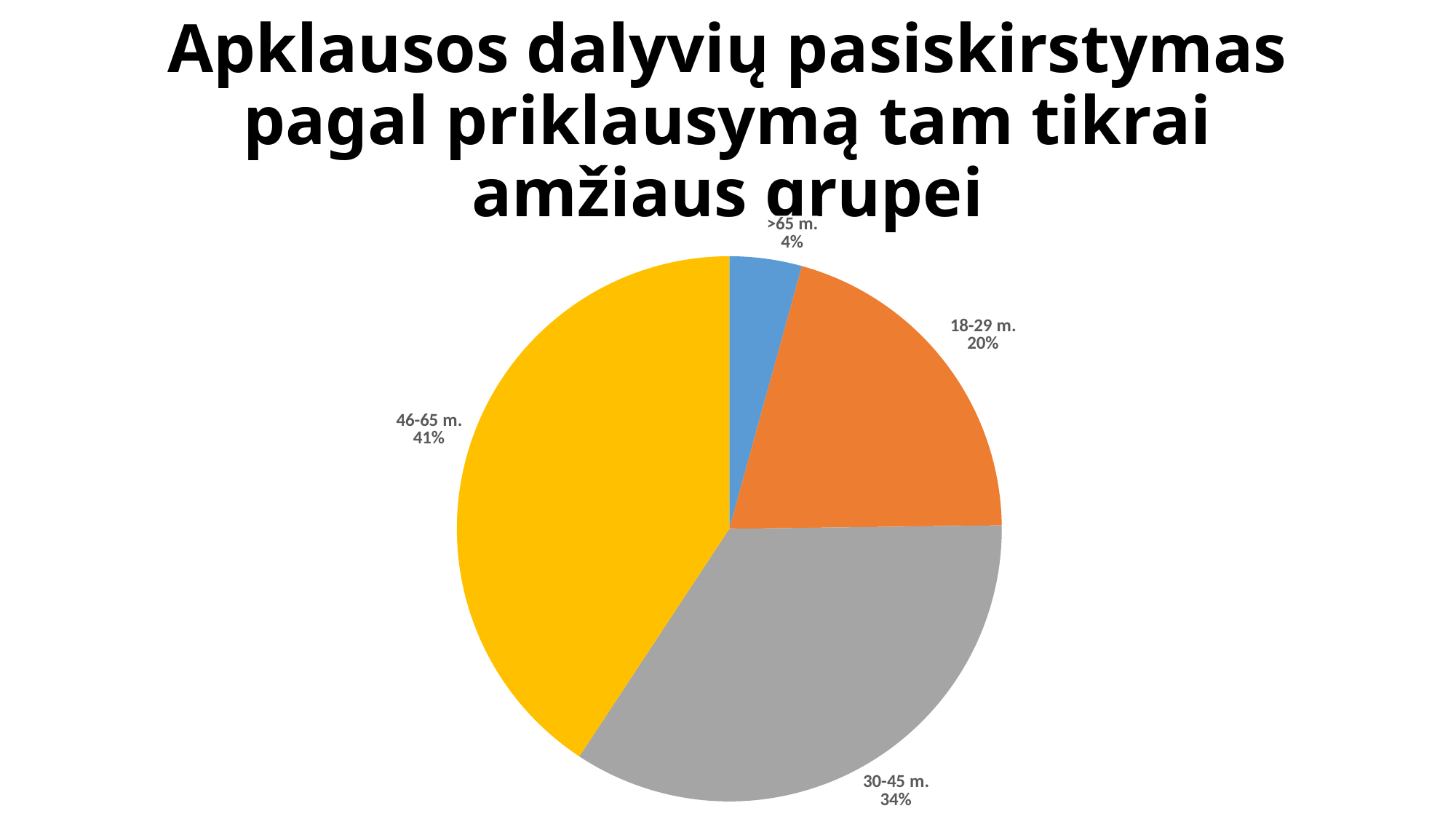
What share of survey participants are in the 30-45 m. age group? 34% What kind of chart is shown on the slide? pie chart Which age group has the largest share of the pie? 46-65 m. What share of survey participants are in the >65 m. age group? 4% What is the title of the chart? Apklausos dalyvių pasiskirstymas pagal priklausymą tam tikrai amžiaus grupei What is the difference in percentage points between the 46-65 m. and 30-45 m. groups? 7 What colour is the slice for the 46-65 m. age group? yellow What share of survey participants are in the 18-29 m. age group? 20% Which age group has the smallest share of the pie? >65 m. What share of survey participants are in the 46-65 m. age group? 41% How many age groups are shown in the pie chart? 4 Which group has a larger share, 18-29 m. or 30-45 m.? 30-45 m.